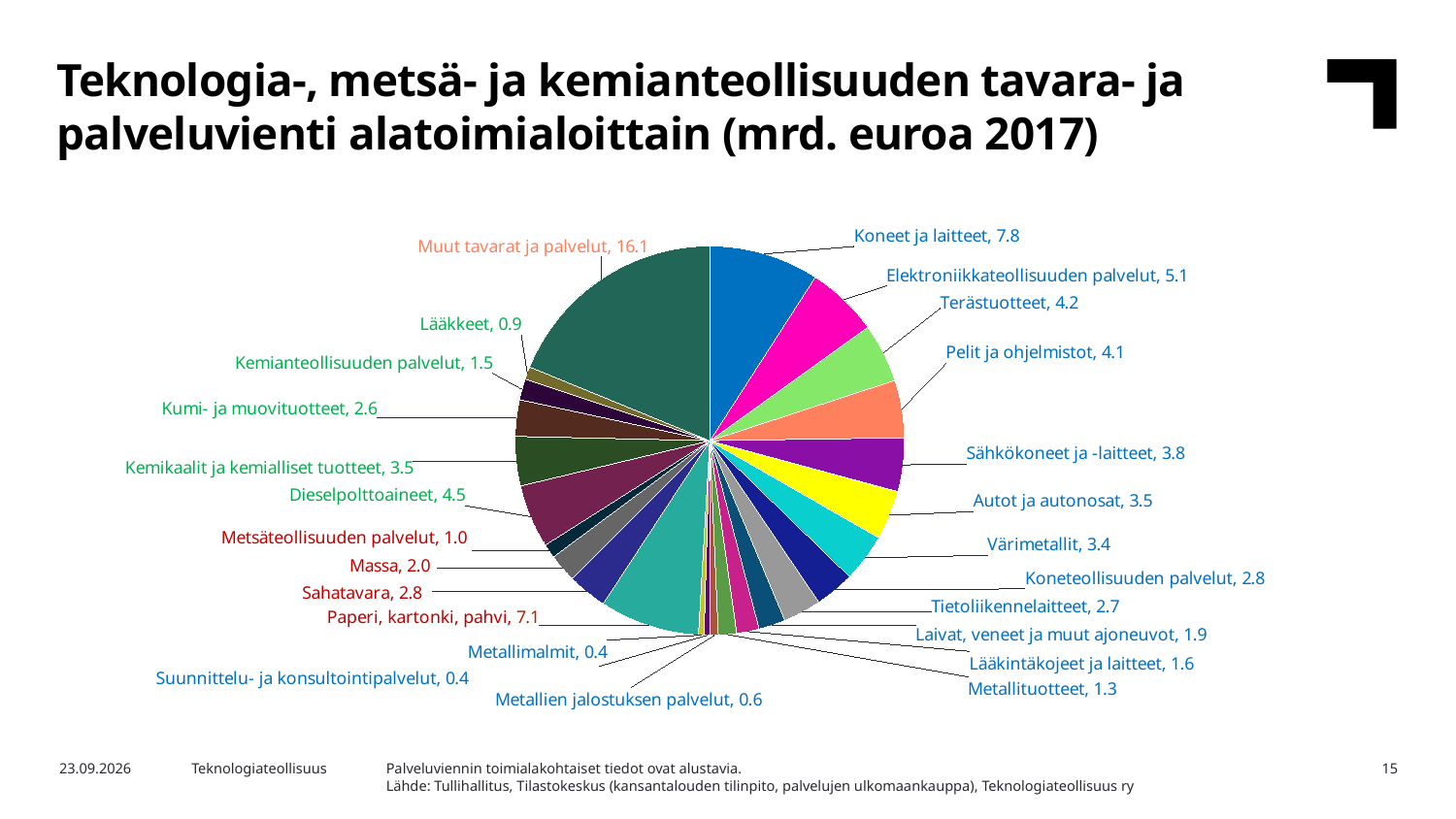
Which is larger, Sähkökoneet ja -laitteet or Tietoliikennelaitteet? Sähkökoneet ja -laitteet Which category has the largest slice of the pie? Muut tavarat ja palvelut What is the difference between Muut tavarat ja palvelut and Koneet ja laitteet? 8.3 What is the value for Koneet ja laitteet? 7.8 In what unit are the values in the chart given, according to the slide title? mrd. euroa What is the value for Elektroniikkateollisuuden palvelut? 5.1 What is the value for Lääkkeet? 0.9 What is the value for Dieselpolttoaineet? 4.5 What kind of chart is shown on the slide? Pie chart What is the difference between Koneet ja laitteet and Paperi, kartonki, pahvi? 0.7 What is the value for Paperi, kartonki, pahvi? 7.1 How many categories (slices) does the pie chart have? 25